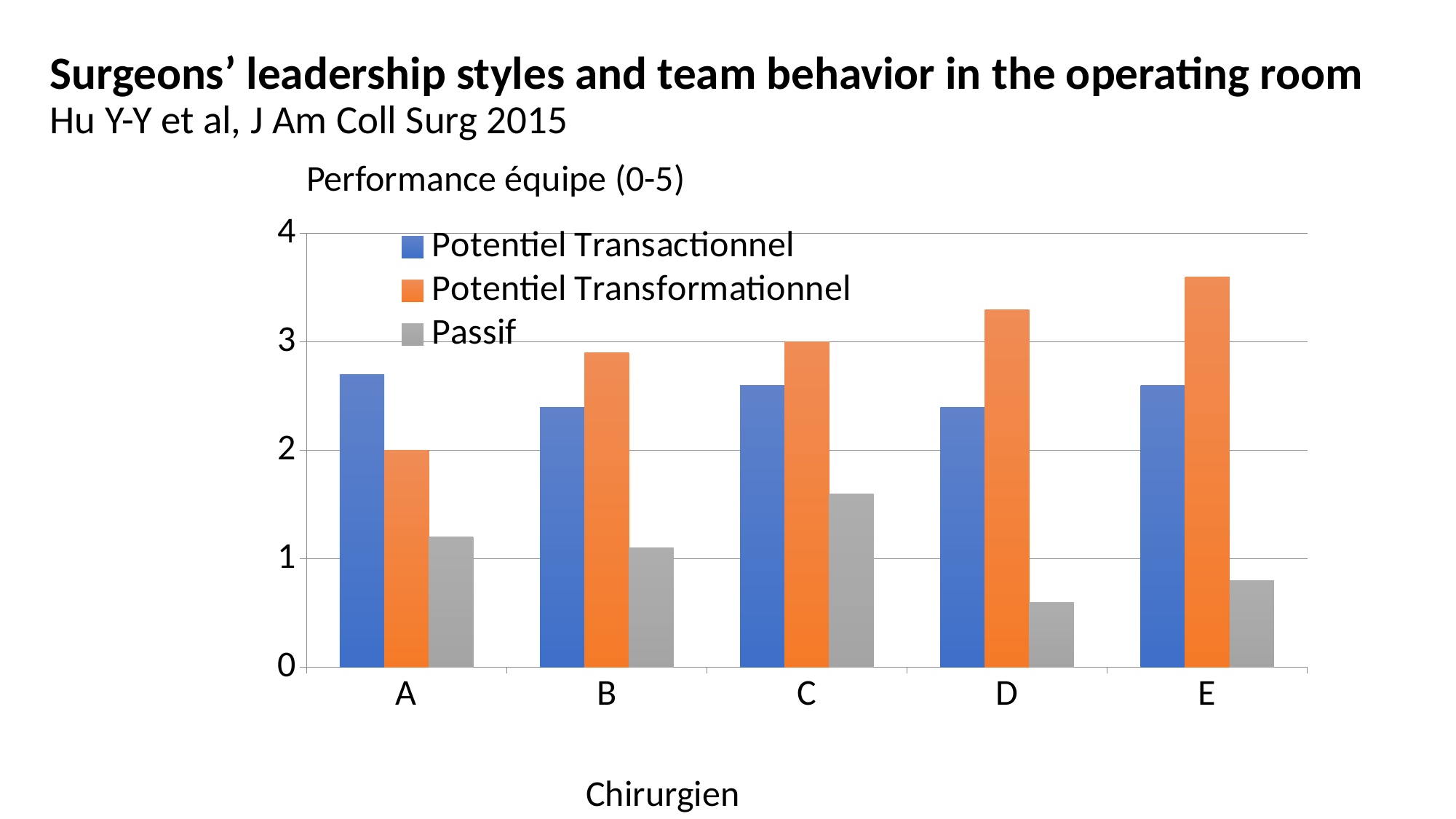
Which surgeon has the highest Passif value? C What is the title of the vertical axis? Performance équipe (0-5) How many series does the legend list? 3 Is the Passif value for surgeon D greater or less than 1? less What is the Potentiel Transformationnel value for surgeon C? 3 What is the Potentiel Transformationnel value for surgeon A? 2 What kind of chart is shown on the slide? bar chart Which surgeon has the lowest Passif value? D Which surgeon has the highest Potentiel Transformationnel value? E For surgeon A, which is larger: Potentiel Transactionnel or Potentiel Transformationnel? Potentiel Transactionnel Does the Potentiel Transformationnel value rise or fall from surgeon A to surgeon E? rise How many surgeons (categories) are shown on the x axis? 5